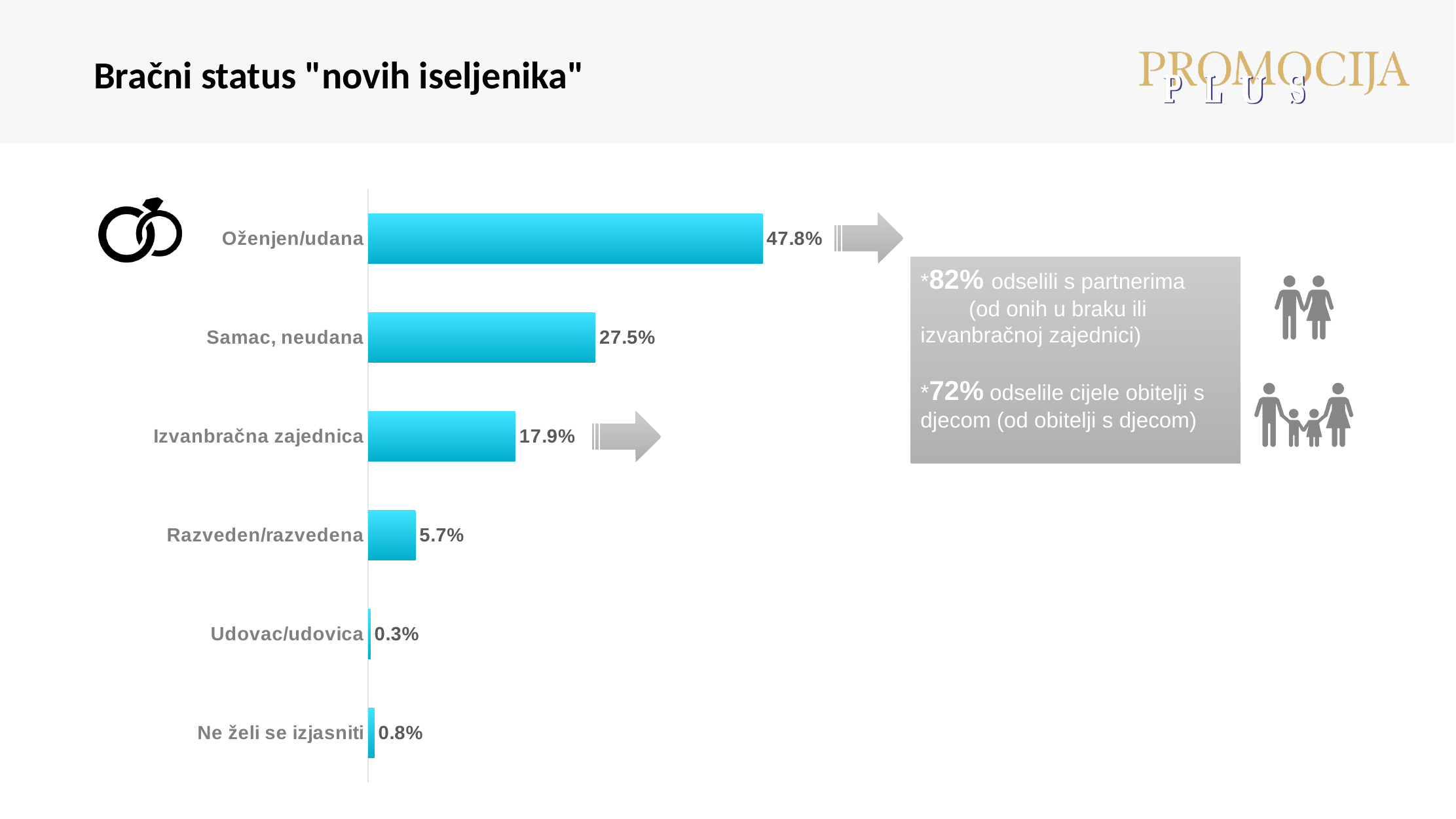
What is the title of the slide? Bračni status "novih iseljenika" What is the difference between the values for Oženjen/udana and Samac, neudana? 20.3% Which category has the lowest value? Udovac/udovica Which category has the highest value? Oženjen/udana What is the value for Udovac/udovica? 0.3% What is the value for Razveden/razvedena? 5.7% How many categories are shown in the chart? 6 What is the value for Oženjen/udana? 47.8% What is the value for Izvanbračna zajednica? 17.9% What kind of chart is shown on the slide? Bar chart Which is larger, the value for Izvanbračna zajednica or the value for Razveden/razvedena? Izvanbračna zajednica What is the value for Samac, neudana? 27.5%